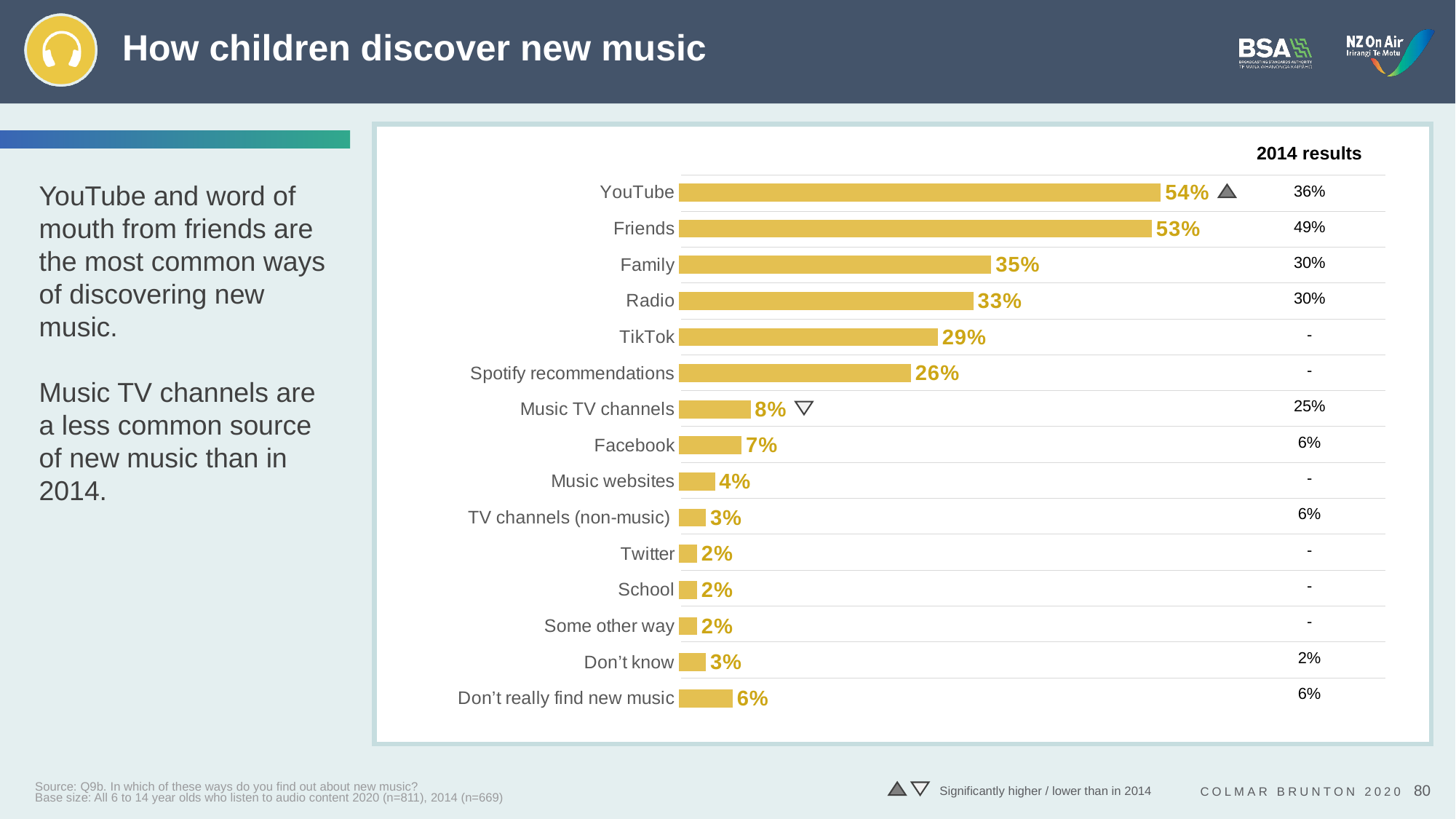
What percentage of children discover new music through YouTube? 54% What was the 2014 result for Music TV channels? 25% What is the value shown for Music TV channels? 8% What is the value shown for TikTok? 29% What was the 2014 result for Friends? 49% Which category has the highest value in the chart? YouTube What is the difference between the values for YouTube and Spotify recommendations? 28% How many categories are plotted in the chart? 15 What is the difference between the values for Family and Radio? 2% What kind of chart is shown on the slide? Bar chart Which is larger, the value for Facebook or the value for Music websites? Facebook Which category is marked as significantly lower than in 2014? Music TV channels